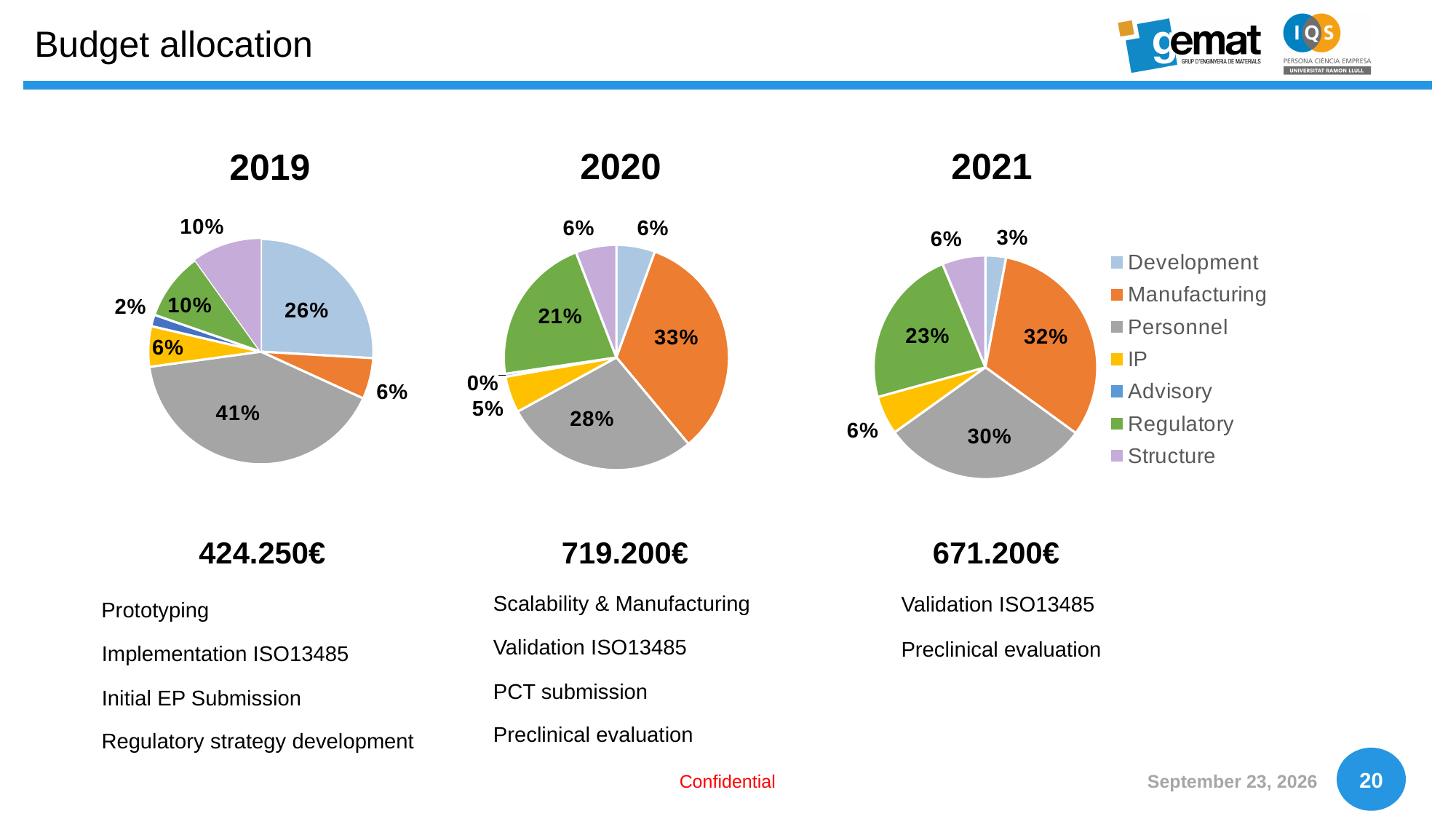
In the 2020 pie chart, what is the difference between the Manufacturing share and the Personnel share? 5% How many series does the legend list? 7 In the 2021 pie chart, what share of the budget goes to Regulatory? 23% In the 2020 pie chart, what share of the budget goes to Development? 6% In the 2019 pie chart, which category has the smallest share? Advisory Which colour represents Regulatory in the legend? Green In the 2019 pie chart, which category has the largest share? Personnel In the 2021 pie chart, which is larger, the Development share or the Structure share? Structure What kind of chart is used for the 2020 budget allocation? Pie chart In the 2020 pie chart, what share of the budget goes to Manufacturing? 33% In the 2021 pie chart, which category has the largest share? Manufacturing In the 2019 pie chart, what share of the budget goes to Personnel? 41%